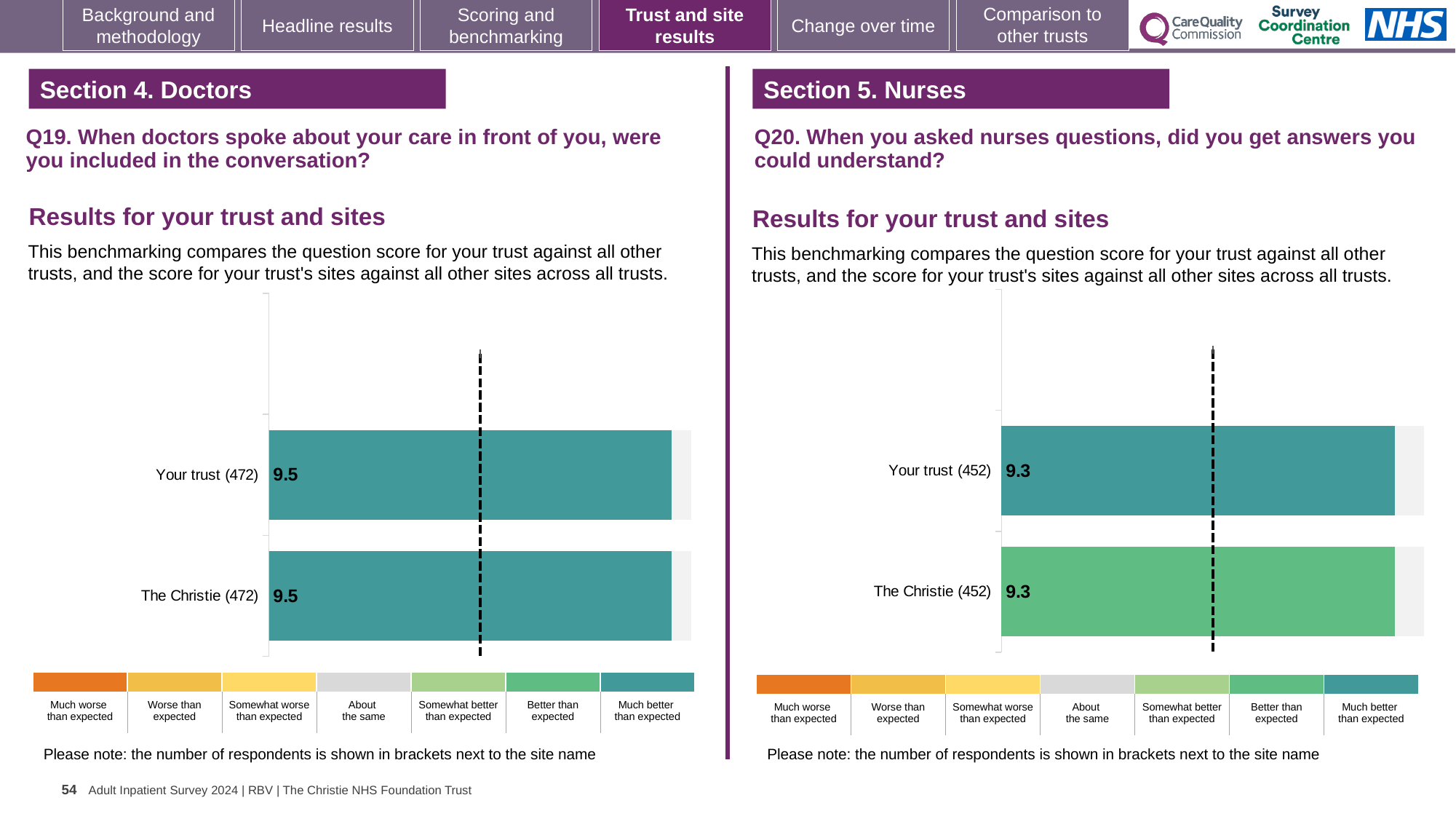
In the Q20 chart (right), which benchmark category does the bar colour for The Christie (452) correspond to? Better than expected In the Q19 chart (left), what is the score for The Christie (472)? 9.5 In the Q19 chart (left), what is the difference between the scores for Your trust and The Christie? 0 How many bars are plotted in the Q20 chart (right)? 2 What kind of chart is used for the Q19 results (left)? Bar chart In the Q19 chart (left), which benchmark category does the bar colour for Your trust (472) correspond to? Much better than expected In the Q19 chart (left), what is the score for Your trust (472)? 9.5 In the Q20 chart (right), what is the score for Your trust (452)? 9.3 How many bars are plotted in the Q19 chart (left)? 2 In the Q20 chart (right), what is the difference between the scores for Your trust and The Christie? 0 How many respondents are shown in brackets for Your trust in the Q20 chart (right)? 452 In the Q20 chart (right), what is the score for The Christie (452)? 9.3